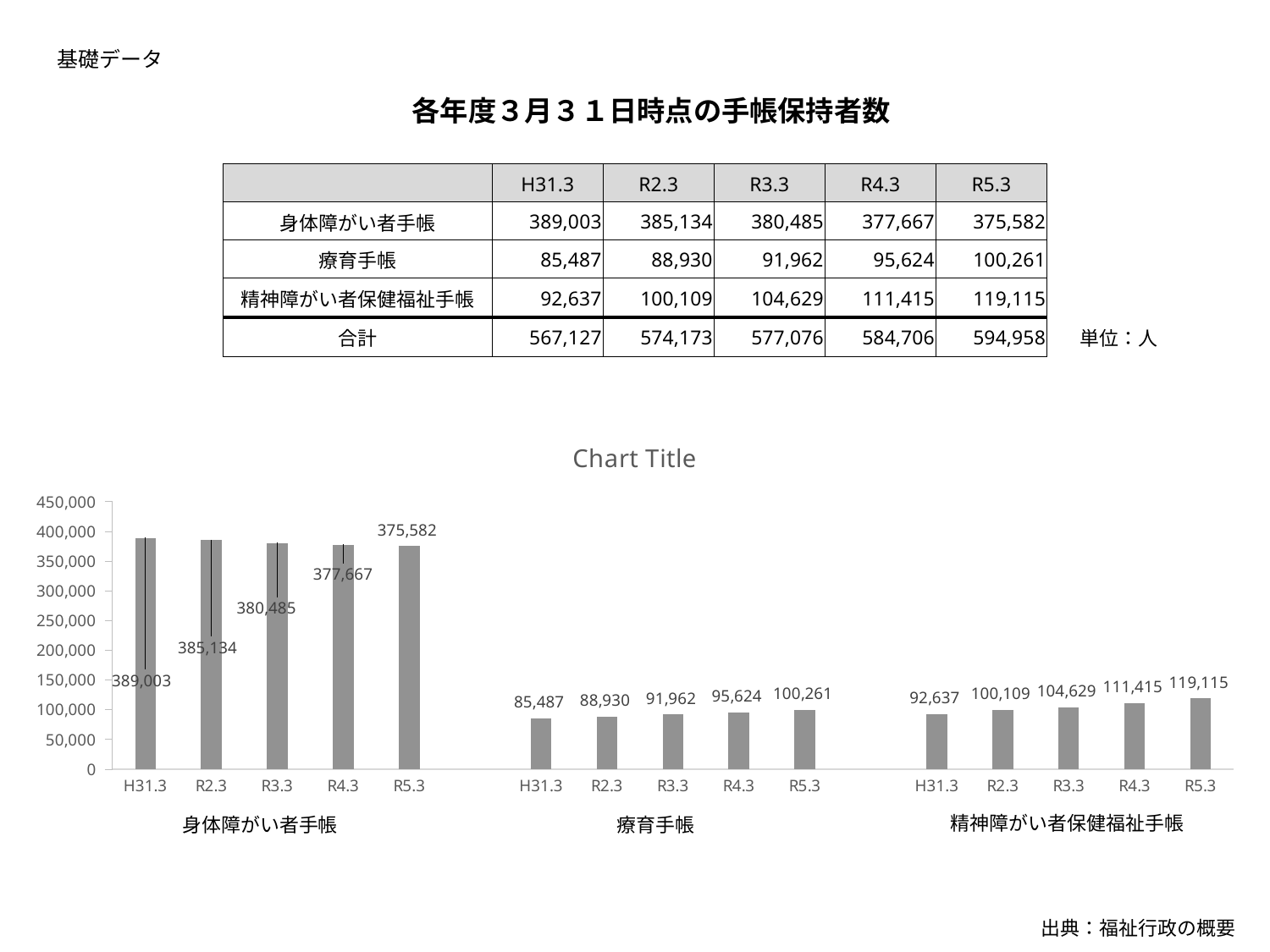
In the chart, what is the difference between the R5.3 and H31.3 values in the 精神障がい者保健福祉手帳 group? 26,478 In the chart, what is the value for R3.3 in the 精神障がい者保健福祉手帳 group? 104,629 What kind of chart is shown on the slide? bar chart How many bars are plotted in the chart in total? 15 In the chart, which bar in the 身体障がい者手帳 group is the highest? H31.3 In the chart, which bar in the 療育手帳 group is the lowest? H31.3 In the chart, is the value for R2.3 in the 身体障がい者手帳 group greater or less than 350,000? greater In the chart, what is the value for H31.3 in the 療育手帳 group? 85,487 In the chart, which is larger: the R5.3 value for 療育手帳 or the R5.3 value for 精神障がい者保健福祉手帳? 精神障がい者保健福祉手帳 In the chart, what is the value for R5.3 in the 身体障がい者手帳 group? 375,582 In the chart, do the values in the 身体障がい者手帳 group rise or fall from H31.3 to R5.3? fall What is the title shown above the chart? Chart Title